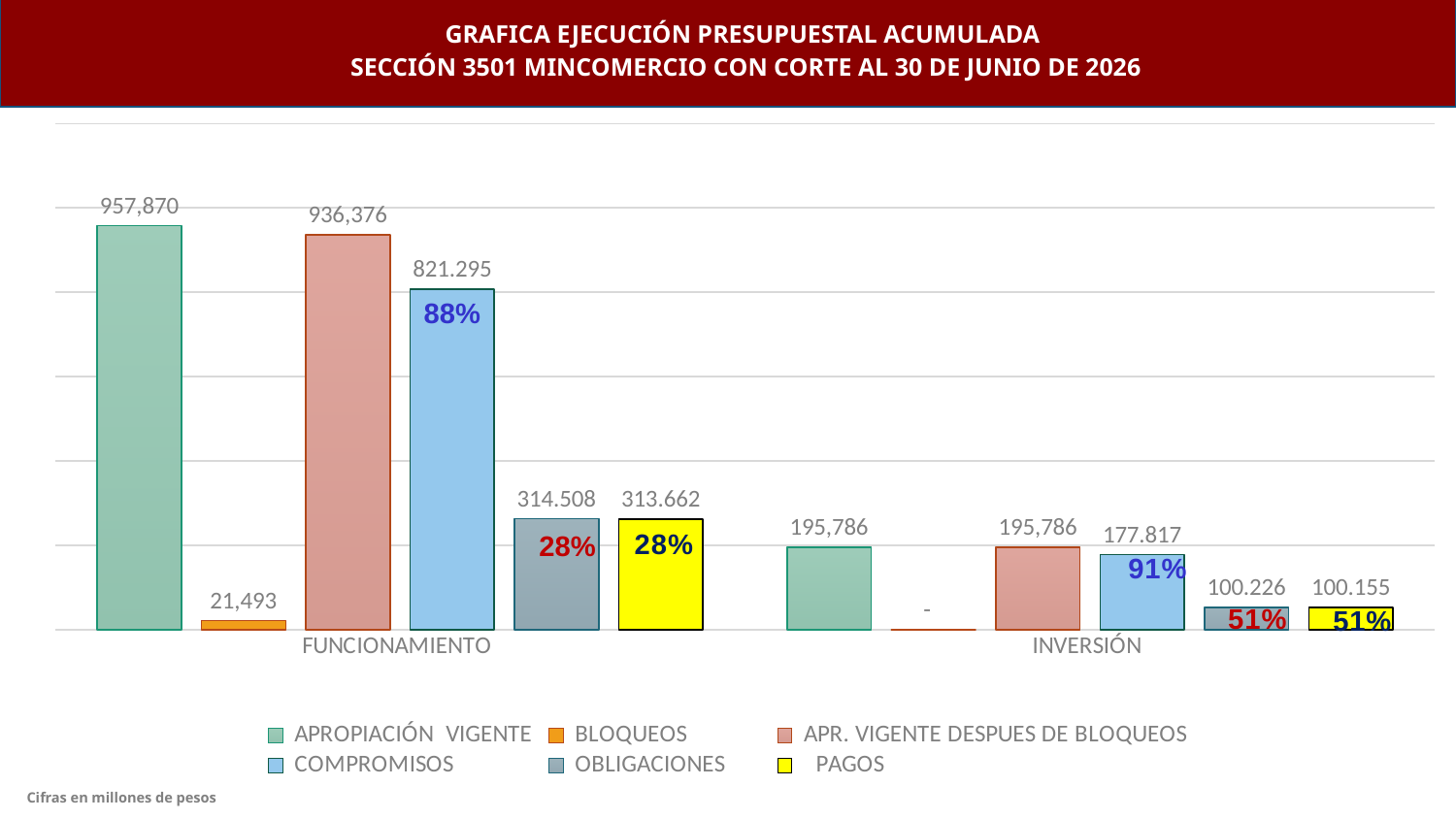
What is the value of COMPROMISOS for INVERSIÓN? 177.817 What is the difference between APROPIACIÓN VIGENTE for FUNCIONAMIENTO and APROPIACIÓN VIGENTE for INVERSIÓN? 762,084 How many series does the legend list? 6 What is the value of APROPIACIÓN VIGENTE for FUNCIONAMIENTO? 957,870 What is the value of BLOQUEOS for FUNCIONAMIENTO? 21,493 Which series has the lowest value for FUNCIONAMIENTO? BLOQUEOS What percentage is shown on the PAGOS bar for INVERSIÓN? 51% What type of chart is shown on the slide? Bar chart Which is larger: COMPROMISOS for FUNCIONAMIENTO or COMPROMISOS for INVERSIÓN? COMPROMISOS for FUNCIONAMIENTO Which series has the highest value for FUNCIONAMIENTO? APROPIACIÓN VIGENTE What is the value of APR. VIGENTE DESPUES DE BLOQUEOS for INVERSIÓN? 195,786 What percentage is shown on the COMPROMISOS bar for FUNCIONAMIENTO? 88%